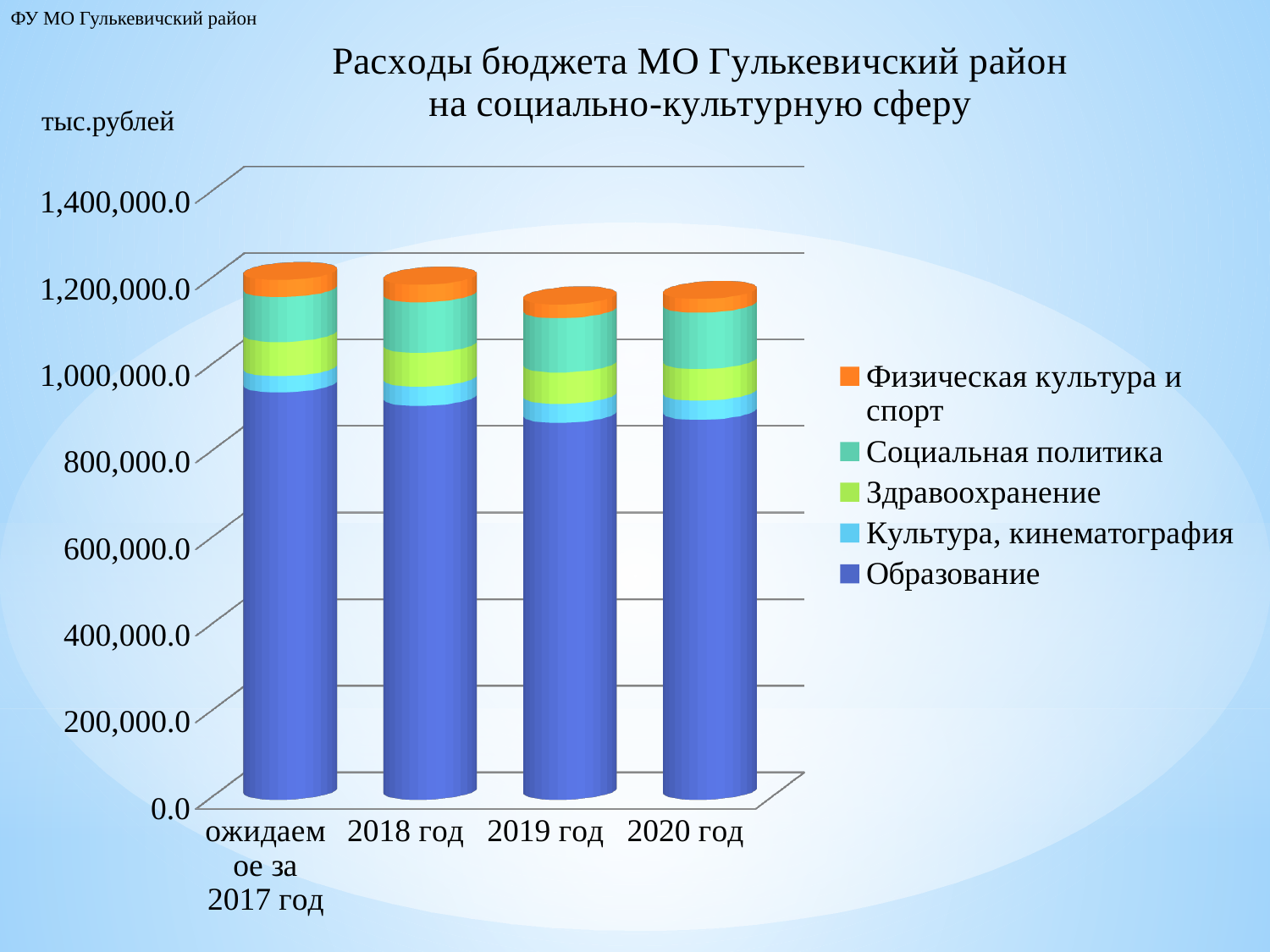
Which is larger: the total stacked value for 'ожидаемое за 2017 год' or for '2019 год'? ожидаемое за 2017 год Is the total stacked value for '2019 год' greater or less than 1,200,000.0? less How many series does the chart's legend list? 5 What kind of chart is shown on the slide? stacked bar chart Is the value of 'Образование' for 'ожидаемое за 2017 год' greater or less than 800,000.0? greater Is the value of 'Образование' for '2019 год' greater or less than 1,000,000.0? less Which period has the highest total stacked value? ожидаемое за 2017 год How many categories (periods) are shown on the x axis of the chart? 4 Which series is shown in orange in the chart's legend? Физическая культура и спорт What is the title of the chart? Расходы бюджета МО Гулькевичский район на социально-культурную сферу Which series accounts for the largest part of each stacked bar? Образование